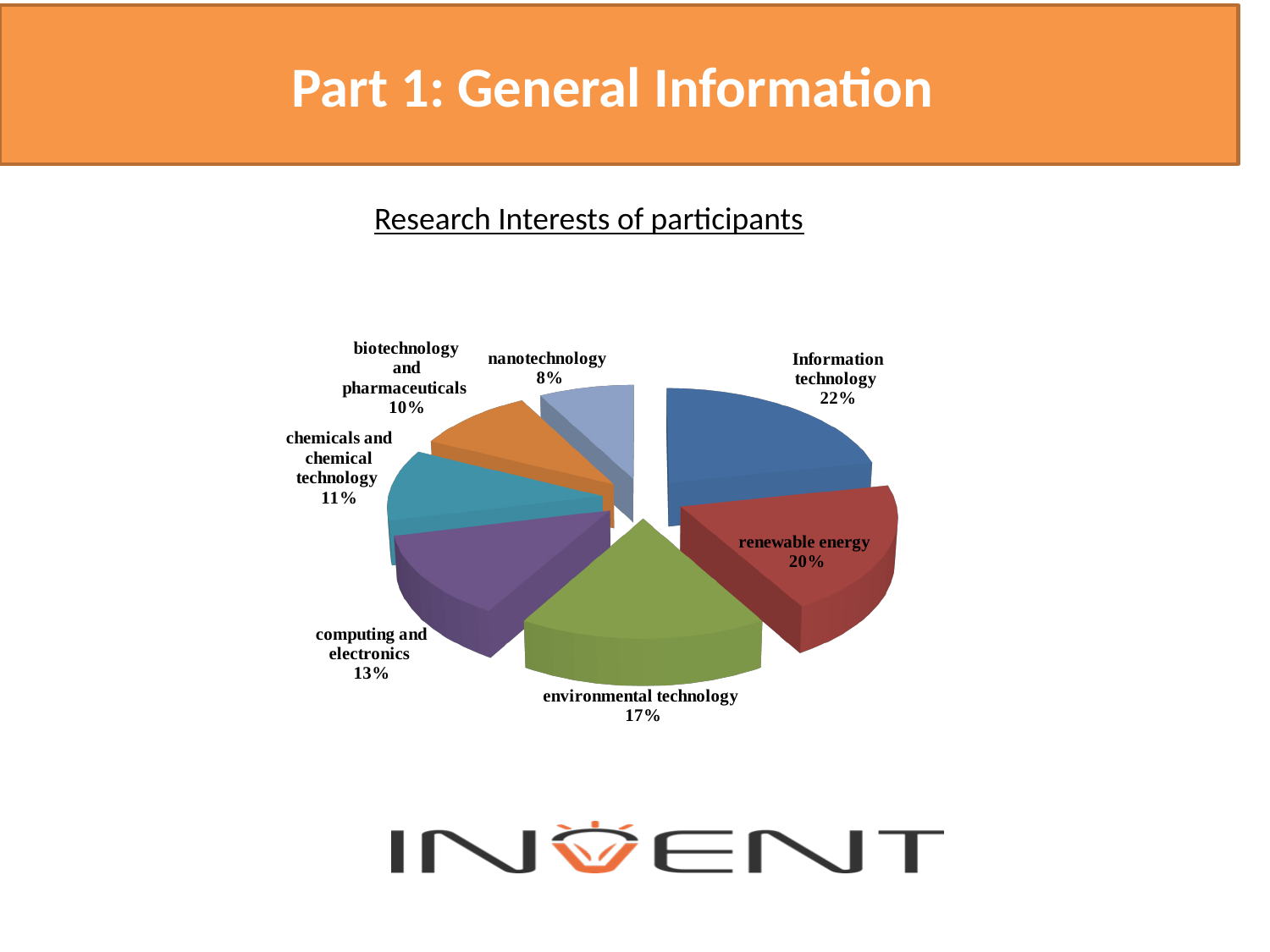
Which research interest has the smallest share of participants? nanotechnology What percentage is shown for renewable energy? 20% Which has a larger share, renewable energy or environmental technology? renewable energy What share is shown for chemicals and chemical technology? 11% What is the difference in percentage points between Information technology and nanotechnology? 14 How many research interest categories are shown in the pie chart? 7 What type of chart is used to show the research interests of participants? pie chart What percentage is shown for nanotechnology? 8% Which research interest has the largest share of participants? Information technology What share of participants have Information technology as a research interest? 22% What share does environmental technology hold in the pie chart? 17% What percentage is shown for computing and electronics? 13%